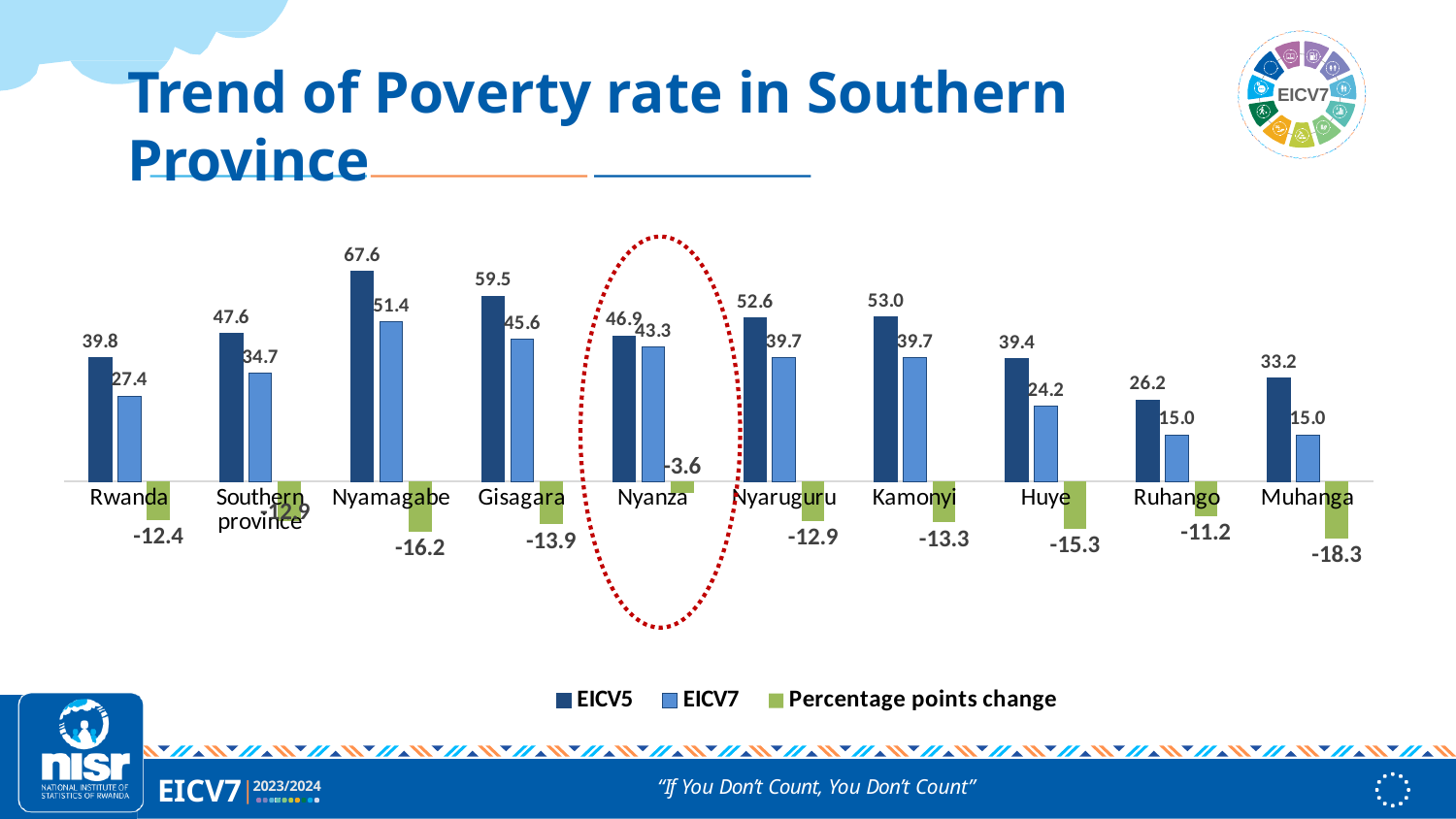
What kind of chart is shown on the slide? Bar chart Which category is highlighted with a red dotted circle? Nyanza Which is larger, the EICV7 poverty rate for Nyanza or for Kamonyi? Nyanza How many series does the legend list? 3 What is the EICV5 poverty rate for Nyamagabe? 67.6 Which category shows the largest decline in percentage points between EICV5 and EICV7? Muhanga Which category has the highest EICV5 poverty rate? Nyamagabe What is the percentage points change shown for Nyanza? -3.6 Which category has the lowest EICV5 poverty rate? Ruhango How many categories are shown on the x axis? 10 What is the difference between the EICV5 and EICV7 poverty rates for Gisagara? 13.9 What is the EICV7 poverty rate for Huye? 24.2